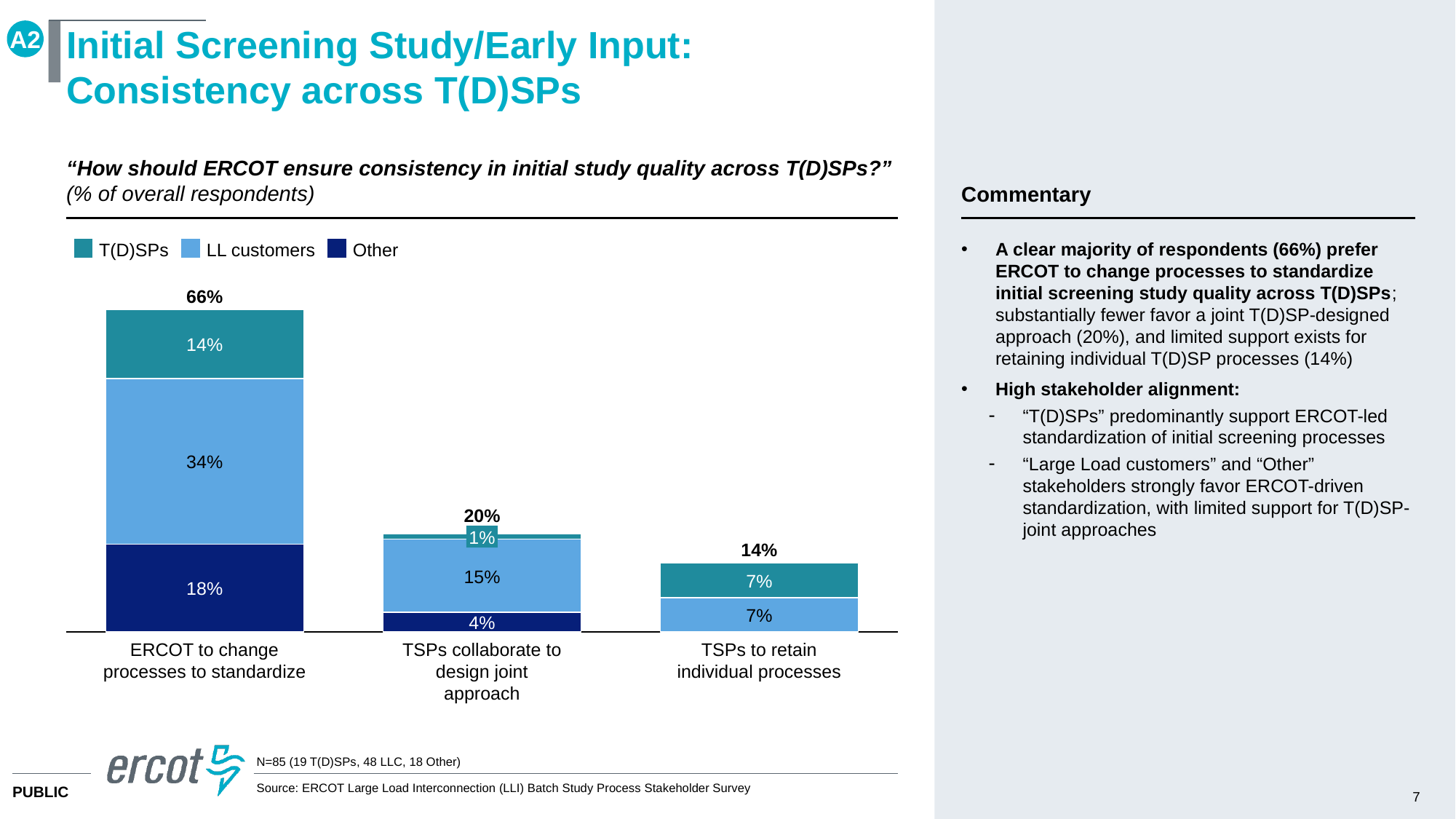
Which is larger: the T(D)SPs value for 'ERCOT to change processes to standardize' or the T(D)SPs value for 'TSPs to retain individual processes'? ERCOT to change processes to standardize Which series is shown in the darkest blue colour in the legend? Other What is the T(D)SPs value for 'TSPs collaborate to design joint approach'? 1% What is the Other value for 'TSPs collaborate to design joint approach'? 4% Which category has the lowest total? TSPs to retain individual processes What type of chart is shown on the slide? Stacked bar chart Which category has the highest total? ERCOT to change processes to standardize How many categories are shown on the x axis? 3 What is the LL customers value for 'ERCOT to change processes to standardize'? 34% What is the total for the 'ERCOT to change processes to standardize' bar? 66% What is the difference between the totals for 'ERCOT to change processes to standardize' and 'TSPs collaborate to design joint approach'? 46% How many series does the legend list? 3